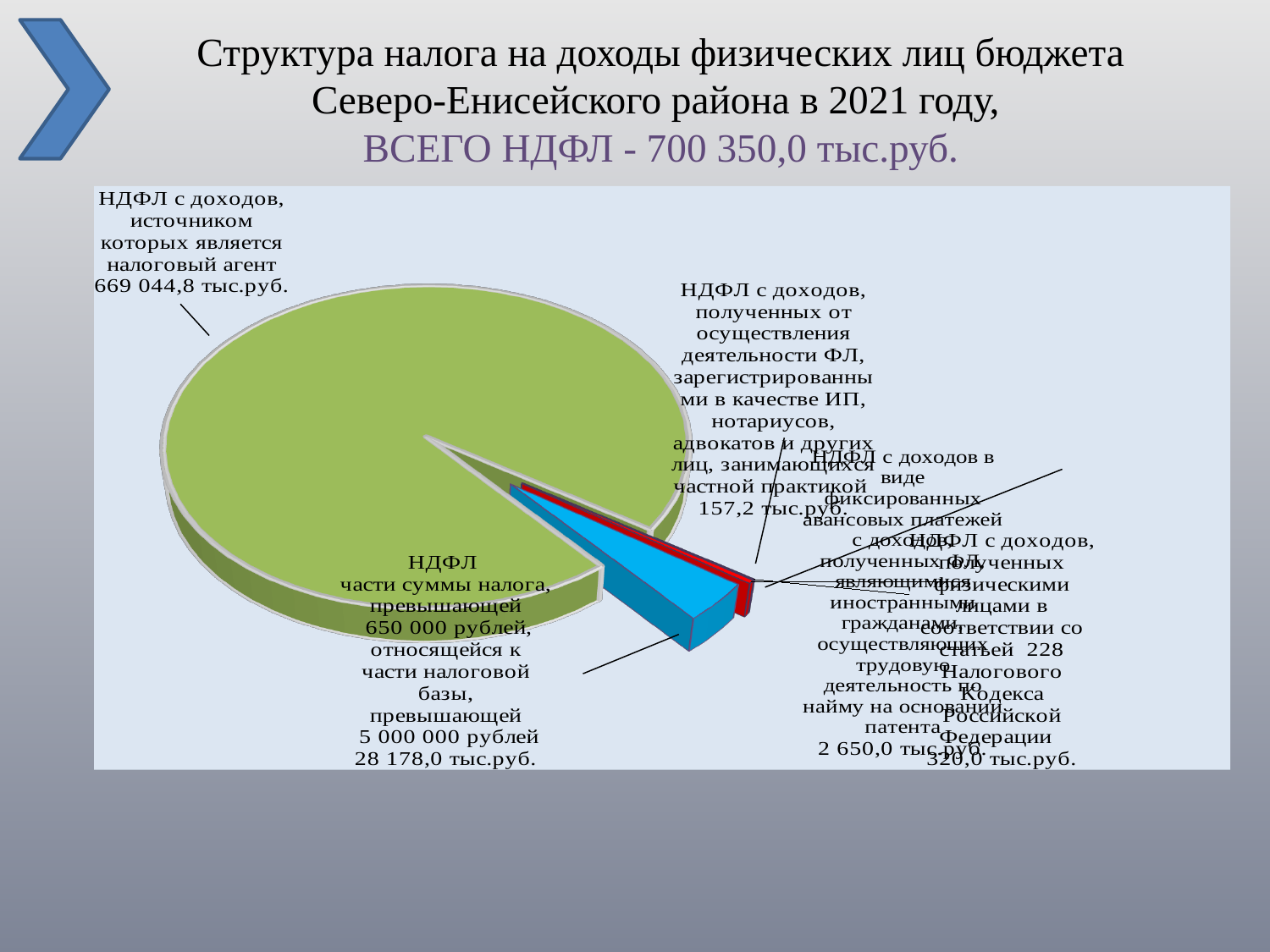
What kind of chart is shown on the slide? pie chart What is the value of НДФЛ с доходов, полученных от осуществления деятельности ФЛ, зарегистрированными в качестве ИП, нотариусов, адвокатов и других лиц, занимающихся частной практикой? 157,2 тыс.руб. What is the value of НДФЛ части суммы налога, превышающей 650 000 рублей? 28 178,0 тыс.руб. What is the difference between the НДФЛ from foreign citizens on a patent (2 650,0 тыс.руб.) and the НДФЛ under article 228 (320,0 тыс.руб.)? 2 330,0 тыс.руб. What is the value of НДФЛ в виде фиксированных авансовых платежей с доходов иностранных граждан, осуществляющих трудовую деятельность по найму на основании патента? 2 650,0 тыс.руб. Which is larger: НДФЛ from foreign citizens working on a patent (2 650,0 тыс.руб.) or НДФЛ under article 228 (320,0 тыс.руб.)? НДФЛ from foreign citizens working on a patent How many slices does the pie chart have? 5 Which category has the smallest value? НДФЛ с доходов, полученных от осуществления деятельности ФЛ, зарегистрированными в качестве ИП, нотариусов, адвокатов и других лиц, занимающихся частной практикой (157,2 тыс.руб.) Which category has the largest slice of the pie? НДФЛ с доходов, источником которых является налоговый агент What is the value of НДФЛ с доходов, источником которых является налоговый агент? 669 044,8 тыс.руб. What is the total НДФЛ stated in the slide title? 700 350,0 тыс.руб. What is the value of НДФЛ с доходов, полученных физическими лицами в соответствии со статьей 228 Налогового кодекса Российской Федерации? 320,0 тыс.руб.